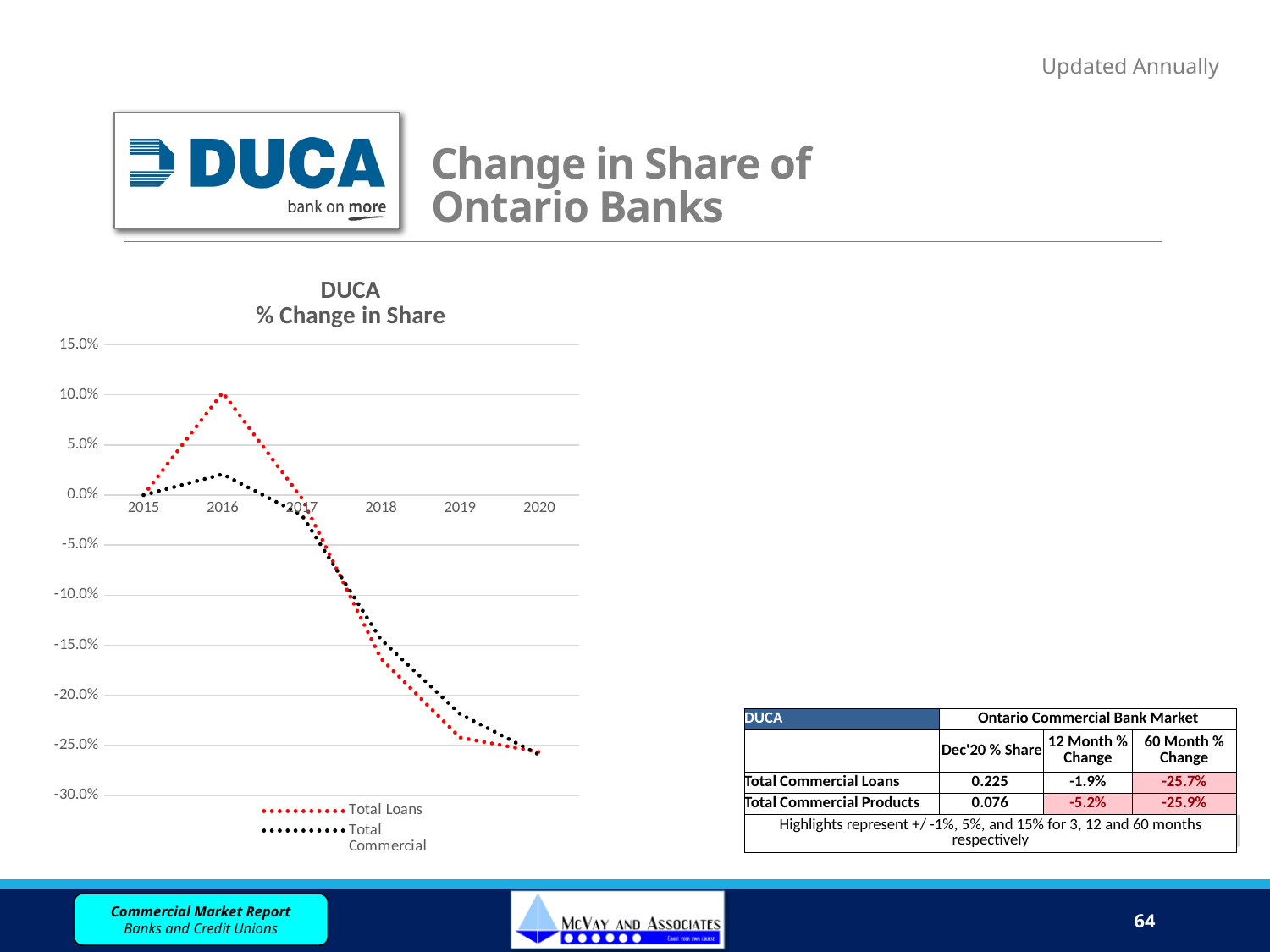
What is the value for Total Loans in 2015? 0.0% Is the value for Total Commercial in 2016 greater or less than 5.0%? less In which year does the Total Commercial series reach its lowest value? 2020 Is the value for Total Loans in 2016 greater or less than 5.0%? greater How many series does the chart legend list? 2 Which colour is used for the Total Loans series in the chart? red How many years are shown on the x axis of the chart? 6 What kind of chart is shown on the slide? line chart Which series has the higher value in 2016, Total Loans or Total Commercial? Total Loans Do the values for Total Commercial rise or fall from 2016 to 2020? fall In which year does the Total Loans series reach its highest value? 2016 Is the value for Total Loans in 2019 greater or less than -20.0%? less